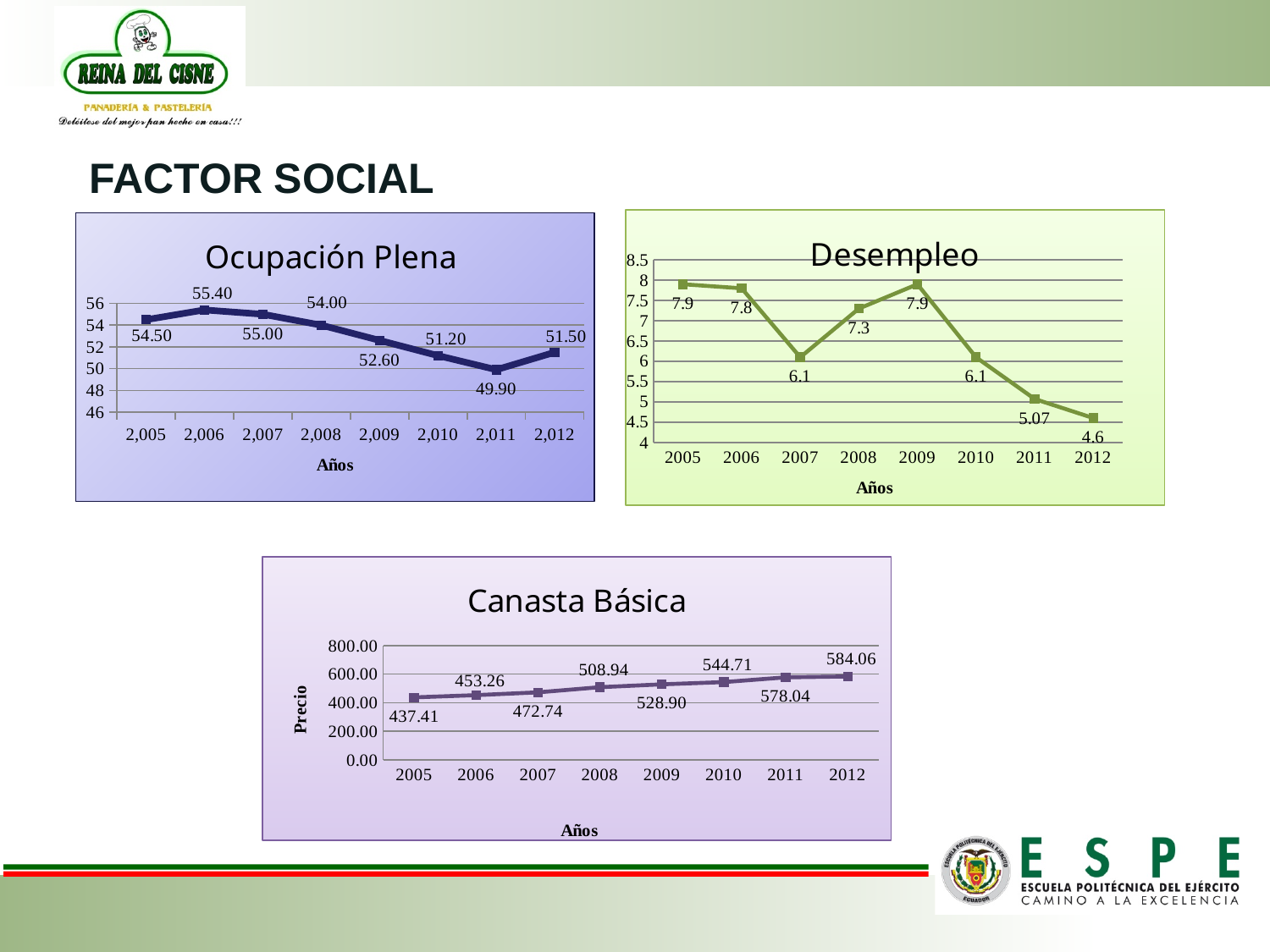
In the Ocupación Plena chart, which year has the lowest value? 2,011 In the Canasta Básica chart, what is the value for 2009? 528.90 In the Desempleo chart, how many years are plotted? 8 In the Ocupación Plena chart, what is the value for 2,006? 55.40 In the Canasta Básica chart, do the values rise or fall from 2005 to 2012? rise In the Desempleo chart, which year has the lowest value? 2012 In the Desempleo chart, is the value for 2008 larger or smaller than the value for 2010? larger In the Desempleo chart, what is the value for 2011? 5.07 In the Canasta Básica chart, what is the difference between the values for 2012 and 2005? 146.65 What kind of chart is the Canasta Básica chart? line chart In the Ocupación Plena chart, what is the difference between the values for 2,006 and 2,011? 5.50 In the Canasta Básica chart, which year has the highest value? 2012